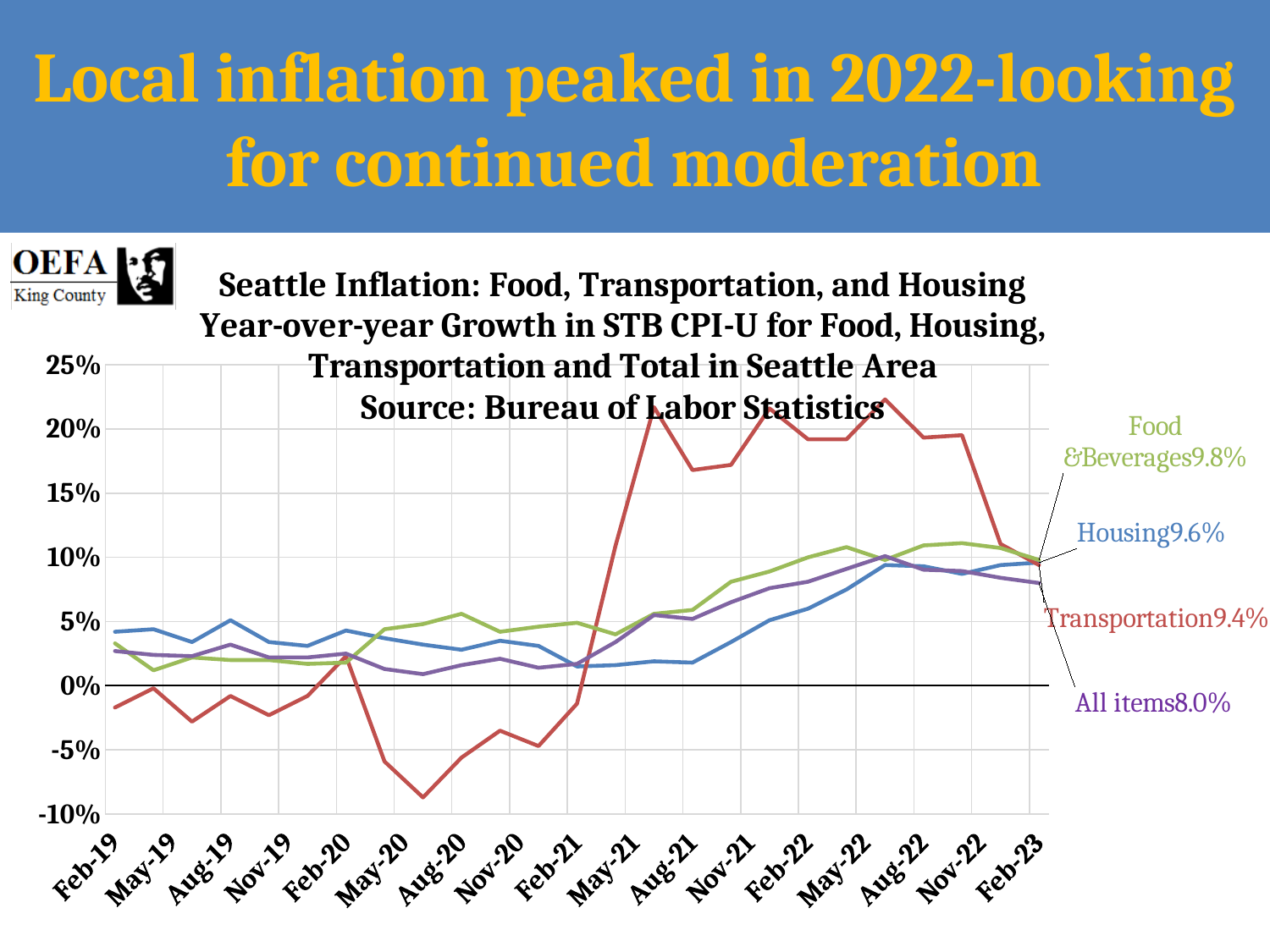
What is the difference between the labelled Feb-23 values for Food & Beverages and All items? 1.8% How many series are plotted on the chart? 4 Is the Transportation value at Feb-19 greater or less than 0%? less Is the Transportation value at Aug-21 greater or less than 15%? greater What source is cited in the chart title? Bureau of Labor Statistics Does the Transportation line rise or fall between Feb-21 and May-21? rise What kind of chart is shown on the slide? line chart Which series has the lowest labelled value at Feb-23? All items What is the Feb-23 value labelled for Food & Beverages? 9.8% What is the Feb-23 value labelled for Housing? 9.6% What is the Feb-23 value labelled for Transportation? 9.4% What is the Feb-23 value labelled for All items? 8.0%